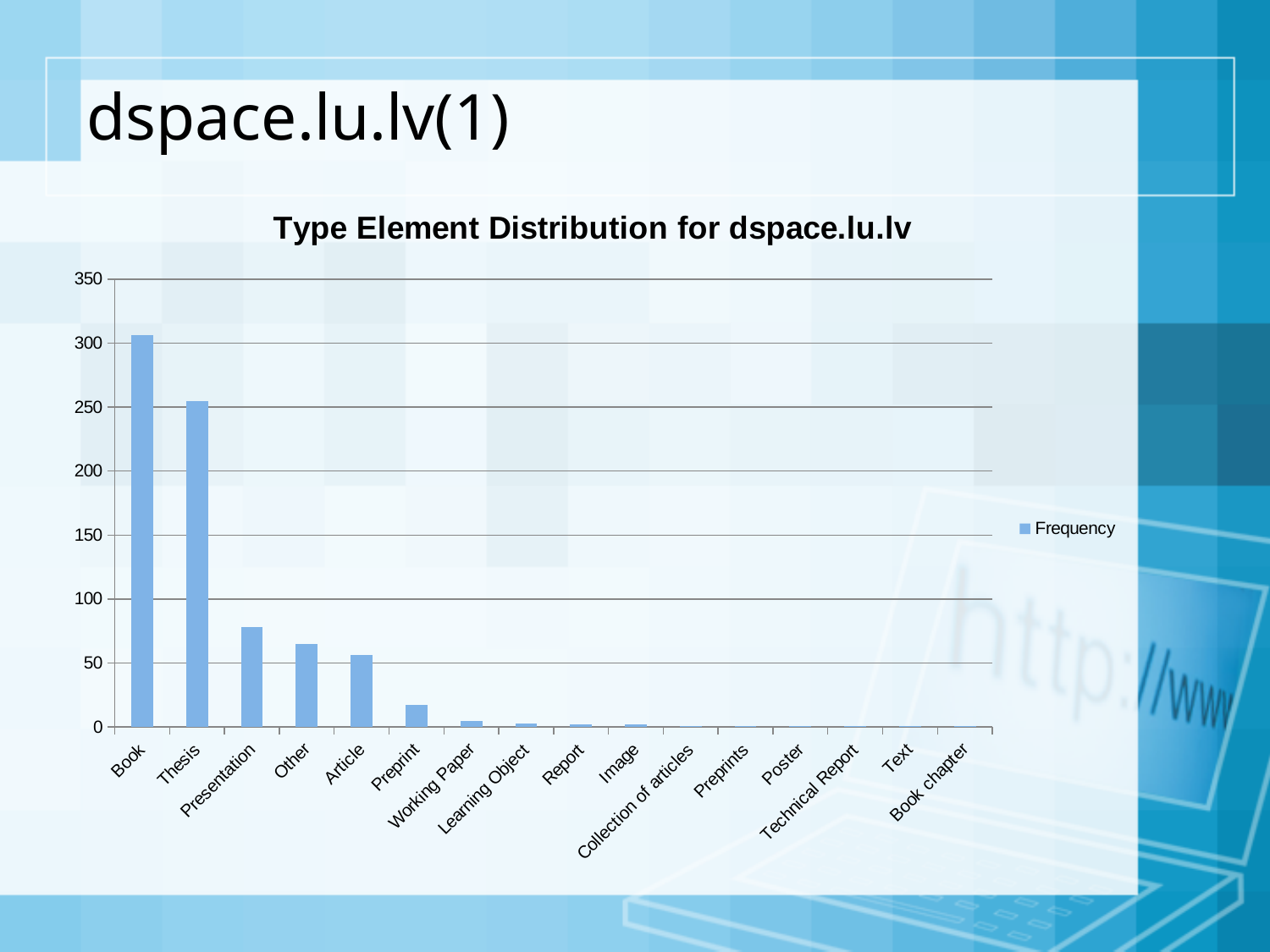
How many categories are shown on the x axis? 16 Which category has the highest frequency? Book What is the name of the series shown in the legend? Frequency What is the title of the chart? Type Element Distribution for dspace.lu.lv Which has a higher frequency, Book or Thesis? Book What kind of chart is shown on the slide? bar chart Is the value for Book greater or less than 250? greater Which has a higher frequency, Presentation or Other? Presentation Is the value for Thesis greater or less than 200? greater Is the value for Presentation greater or less than 100? less Do the values generally rise or fall moving from left to right along the x axis? fall How many series does the legend list? 1